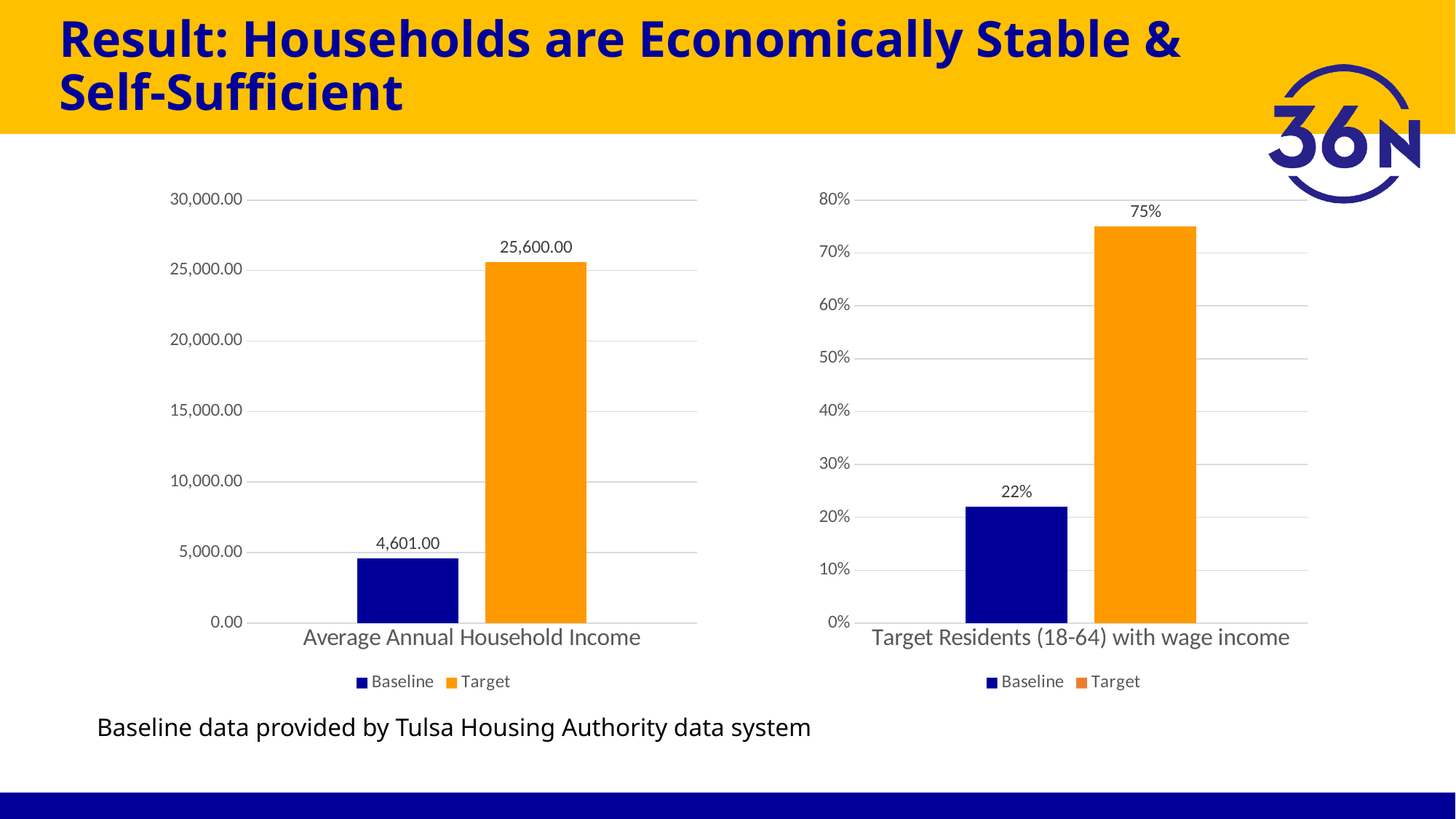
In the left chart (Average Annual Household Income), which series has the higher value, Baseline or Target? Target In the left chart (Average Annual Household Income), what colour is the Target bar? orange In the right chart (Target Residents (18-64) with wage income), what is the Target value? 75% In the left chart (Average Annual Household Income), what is the Target value? 25,600.00 In the right chart (Target Residents (18-64) with wage income), what is the Baseline value? 22% In the left chart (Average Annual Household Income), what is the difference between the Target and Baseline values? 20,999.00 In the left chart (Average Annual Household Income), what is the Baseline value? 4,601.00 How many series does the legend of the right chart (Target Residents (18-64) with wage income) list? 2 In the right chart (Target Residents (18-64) with wage income), what is the difference between the Target and Baseline values? 53% In the left chart (Average Annual Household Income), is the Baseline value greater or less than 5,000.00? less What kind of chart is the left chart (Average Annual Household Income)? bar chart In the right chart (Target Residents (18-64) with wage income), which series has the lower value, Baseline or Target? Baseline